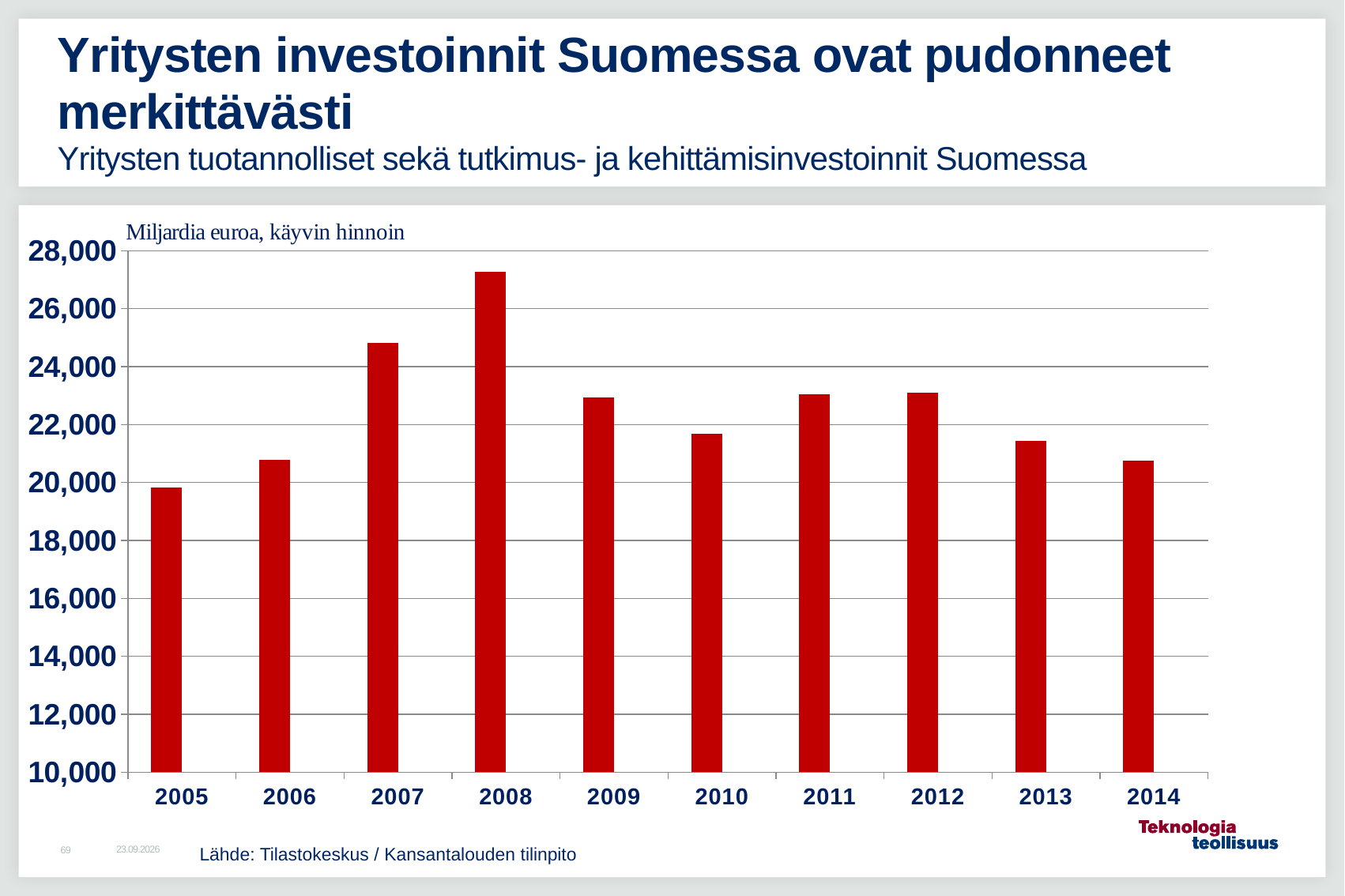
What unit label is printed above the chart's y axis? Miljardia euroa, käyvin hinnoin What kind of chart is shown on the slide? Bar chart Is the value for 2007 greater or less than 24,000? greater Is the value for 2013 greater or less than 22,000? less How many years are shown on the x axis of the chart? 10 Which year has the lowest value in the chart? 2005 Is the value for 2008 greater or less than 26,000? greater Which year has the highest value in the chart? 2008 Which is larger, the value for 2007 or the value for 2009? 2007 Do the values rise or fall from 2008 to 2010? fall Which is larger, the value for 2006 or the value for 2010? 2010